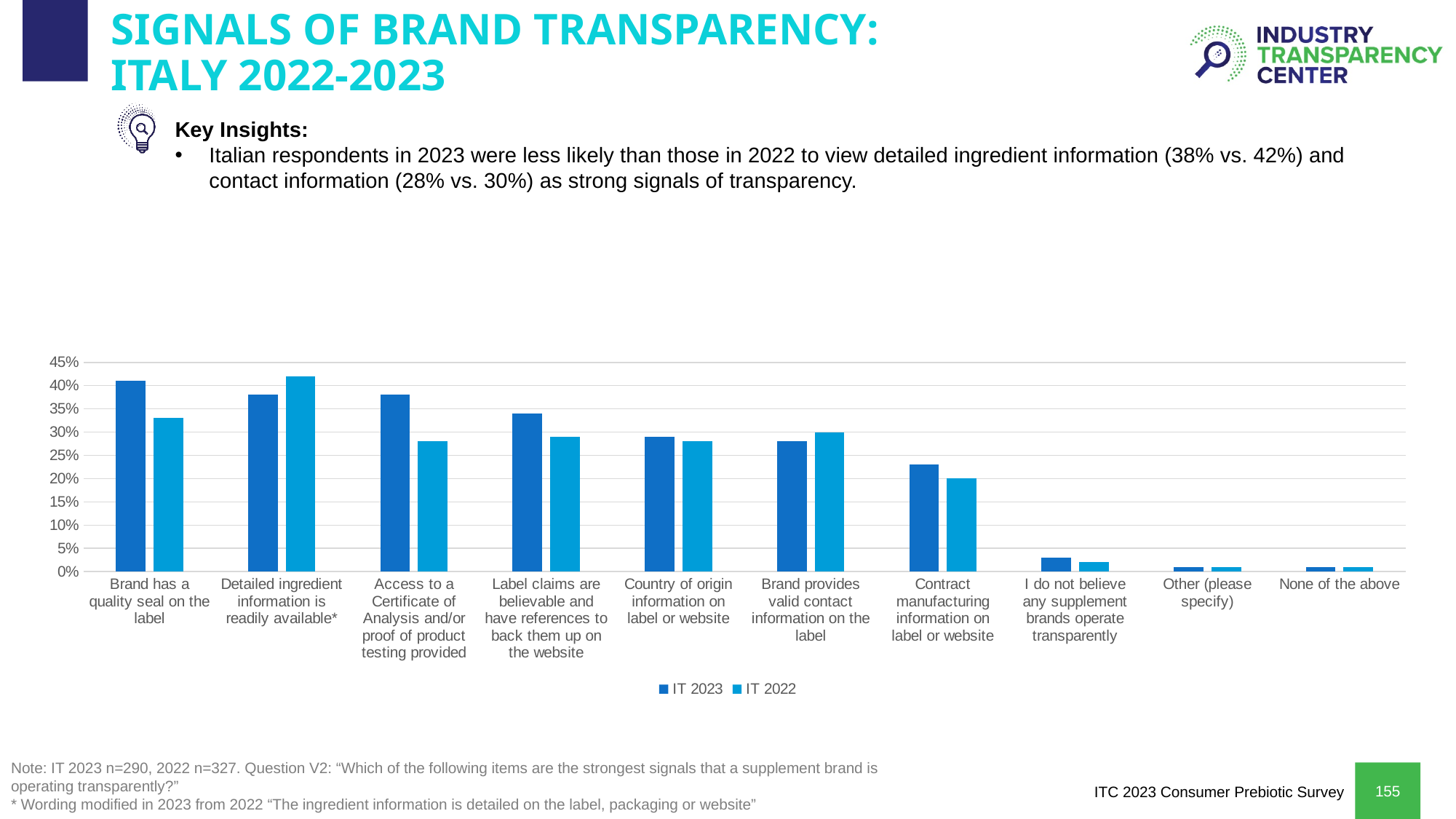
Which category has the highest IT 2022 value? Detailed ingredient information is readily available* Is the IT 2023 value for 'I do not believe any supplement brands operate transparently' greater or less than 5%? less Which category has the highest IT 2023 value? Brand has a quality seal on the label What are the two series named in the chart legend? IT 2023 and IT 2022 Is the IT 2022 value for 'Detailed ingredient information is readily available*' greater or less than 40%? greater How many series does the chart legend list? 2 Is the IT 2023 value for 'Label claims are believable and have references to back them up on the website' greater or less than 30%? greater What kind of chart is shown on the slide? bar chart For 'Access to a Certificate of Analysis and/or proof of product testing provided', which series has the larger value, IT 2023 or IT 2022? IT 2023 For 'Detailed ingredient information is readily available*', which series has the larger value, IT 2023 or IT 2022? IT 2022 How many categories are shown along the x axis of the chart? 10 For 'Brand has a quality seal on the label', which series has the larger value, IT 2023 or IT 2022? IT 2023